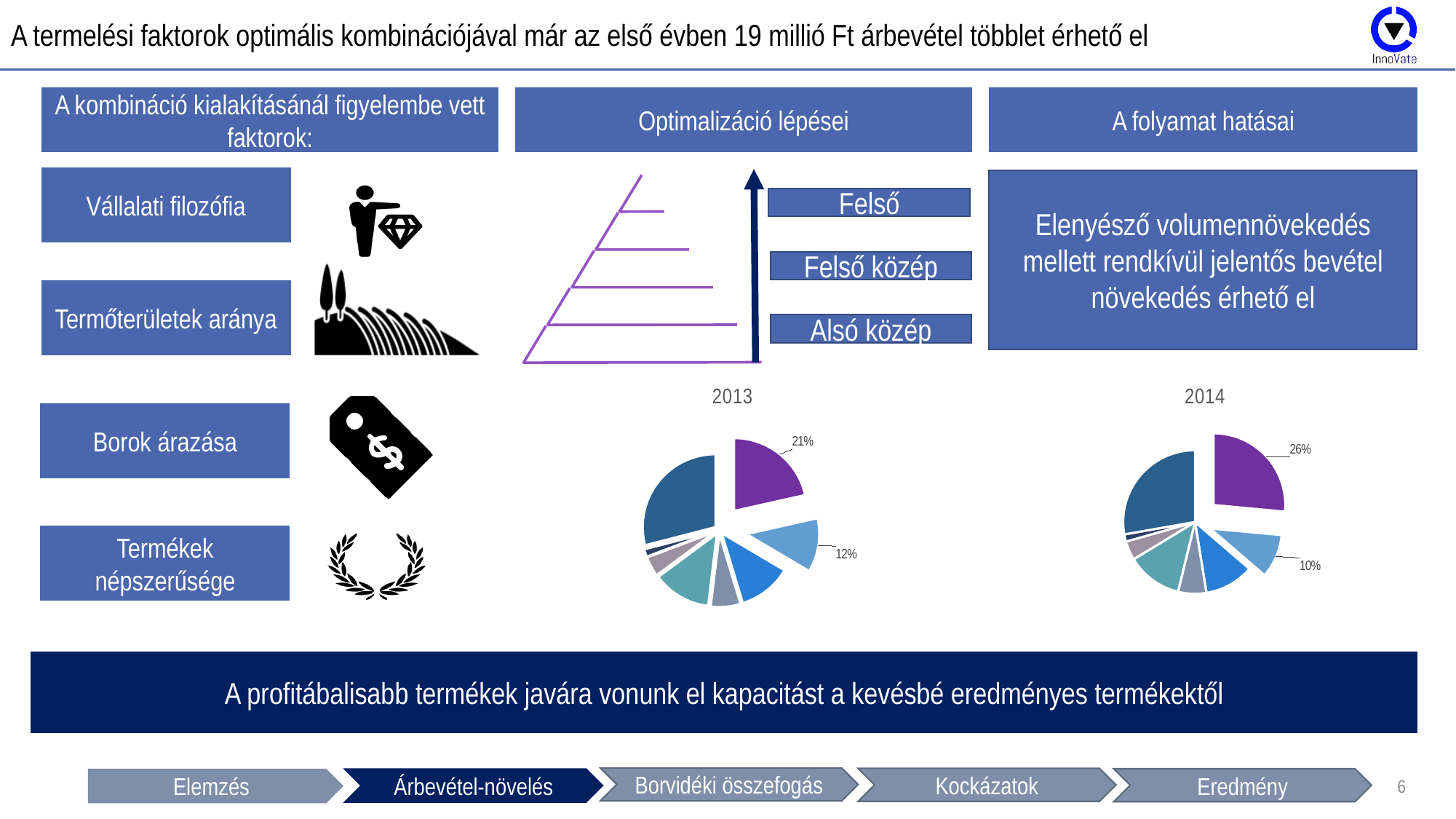
Is the light blue slice larger in the 2013 pie chart or in the 2014 pie chart? 2013 In the 2014 pie chart, what value is printed on the purple slice? 26% How many pie charts are shown on the slide? 2 In the 2014 pie chart, what value is printed on the light blue slice? 10% In the 2013 pie chart, which of the two labelled slices is larger, the purple one or the light blue one? the purple one (21%) In the 2014 pie chart, what is the difference between the two labelled slices (26% and 10%)? 16 percentage points What are the titles of the two pie charts on the slide? 2013 and 2014 Is the purple slice larger in the 2013 pie chart or in the 2014 pie chart? 2014 In the 2013 pie chart, what value is printed on the light blue slice? 12% In the 2013 pie chart, what value is printed on the purple slice? 21% What kind of chart is shown under the heading 2013? pie chart In the 2013 pie chart, what is the difference between the two labelled slices (21% and 12%)? 9 percentage points